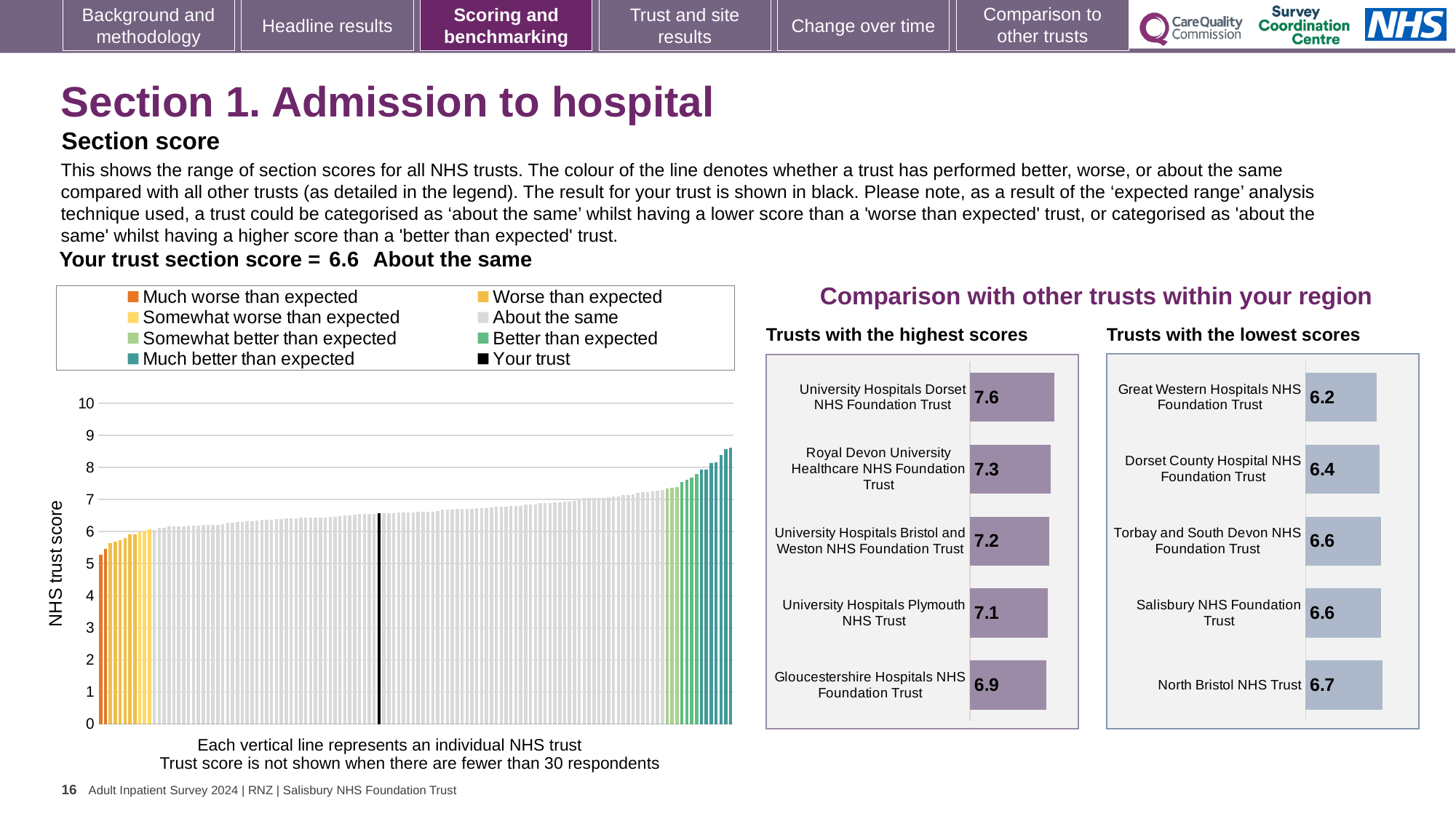
In the 'Trusts with the highest scores' chart, what is the score for University Hospitals Dorset NHS Foundation Trust? 7.6 How many trusts are shown in the 'Trusts with the highest scores' chart? 5 In the 'Trusts with the lowest scores' chart, what is the score for North Bristol NHS Trust? 6.7 What is the y-axis label of the large chart on the left? NHS trust score In the 'Trusts with the lowest scores' chart, what is the difference between the scores of North Bristol NHS Trust and Great Western Hospitals NHS Foundation Trust? 0.5 In the 'Trusts with the highest scores' chart, what is the difference between the scores of University Hospitals Dorset NHS Foundation Trust and Gloucestershire Hospitals NHS Foundation Trust? 0.7 How many entries does the legend of the large chart on the left list? 8 What kind of chart is the large chart on the left showing NHS trust scores? bar chart In the 'Trusts with the highest scores' chart, which trust has the highest score? University Hospitals Dorset NHS Foundation Trust In the 'Trusts with the lowest scores' chart, what is the score for Great Western Hospitals NHS Foundation Trust? 6.2 In the 'Trusts with the lowest scores' chart, which trust has the lowest score? Great Western Hospitals NHS Foundation Trust In the 'Trusts with the highest scores' chart, which has the higher score: Royal Devon University Healthcare NHS Foundation Trust or University Hospitals Plymouth NHS Trust? Royal Devon University Healthcare NHS Foundation Trust